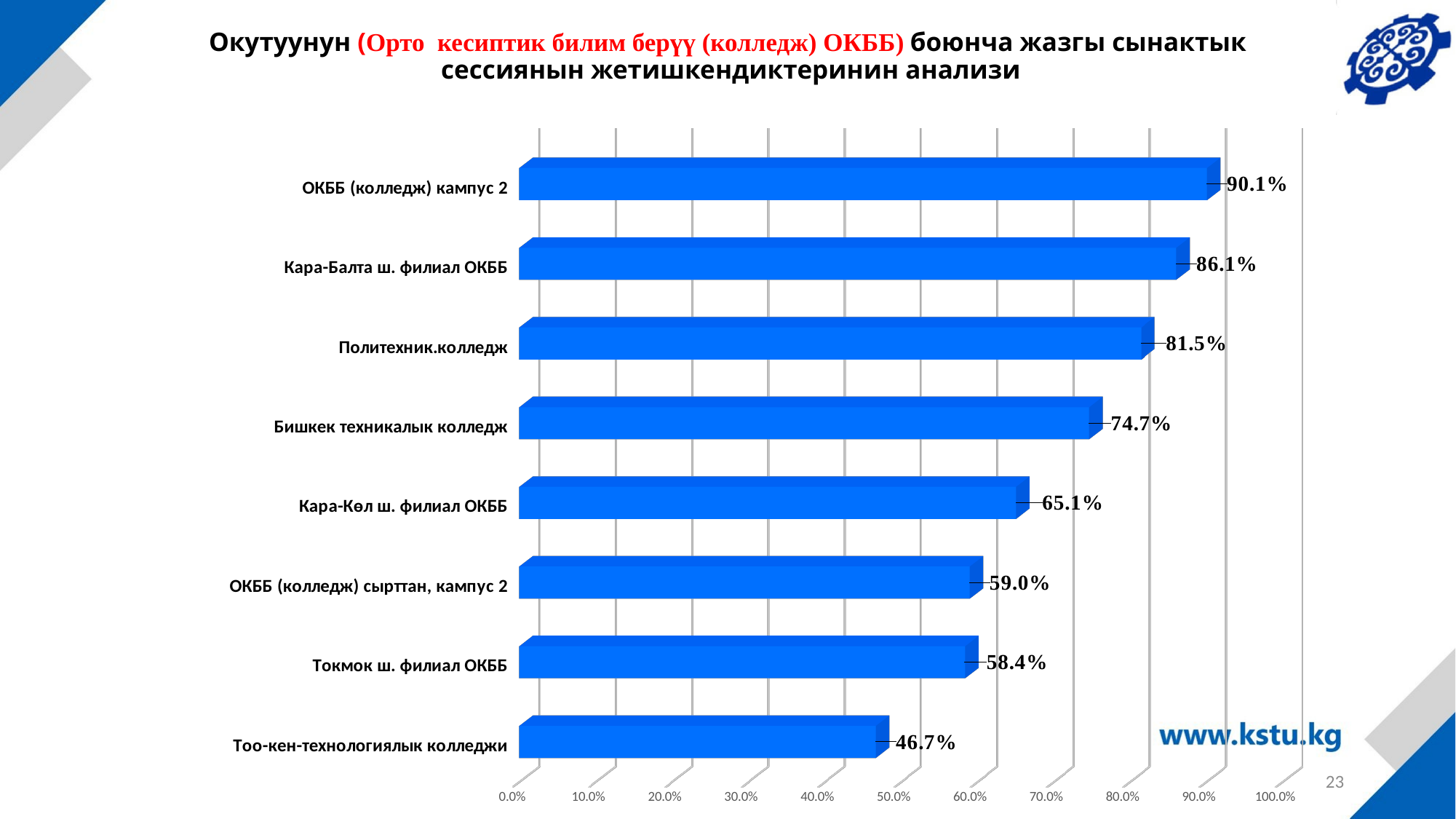
Which category has the lowest value? Тоо-кен-технологиялык колледжи What is the value for Токмок ш. филиал ОКББ? 58.4% What is the difference between the values for Кара-Балта ш. филиал ОКББ and Политехник.колледж? 4.6% Which is larger, the value for Кара-Көл ш. филиал ОКББ or the value for Бишкек техникалык колледж? Бишкек техникалык колледж What is the value for Бишкек техникалык колледж? 74.7% Is the value for Политехник.колледж greater or less than 80.0%? greater What colour are the bars in the chart? Blue What kind of chart is shown on the slide? Bar chart How many categories are shown in the chart? 8 What is the value for ОКББ (колледж) кампус 2? 90.1% Which category has the highest value? ОКББ (колледж) кампус 2 What is the difference between the values for ОКББ (колледж) кампус 2 and Тоо-кен-технологиялык колледжи? 43.4%